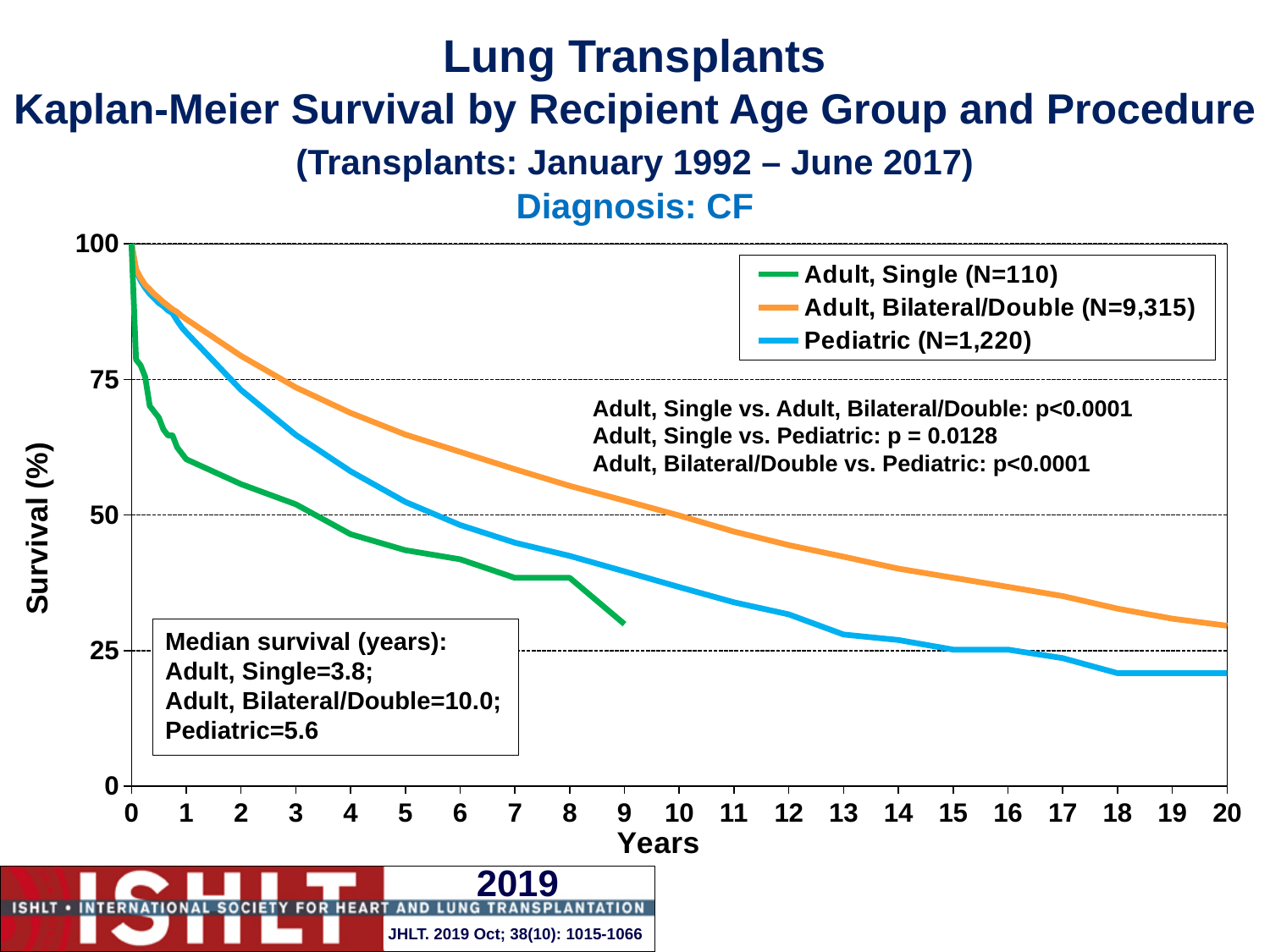
Which group has the lowest median survival? Adult, Single What is the median survival in years for the Pediatric group? 5.6 What is the median survival in years for the Adult, Single group? 3.8 Which group has the highest median survival? Adult, Bilateral/Double Is the survival value for the Adult, Bilateral/Double group at 20 years greater or less than 25? greater What kind of chart is shown on the slide? line chart How many series does the legend list? 3 What is the difference in median survival (years) between the Adult, Bilateral/Double group and the Pediatric group? 4.4 Do the survival curves rise or fall as years increase along the x axis? fall Is the survival value for the Pediatric group at 18 years greater or less than 25? less At 5 years, which curve shows higher survival: Adult, Bilateral/Double or Pediatric? Adult, Bilateral/Double What is the median survival in years for the Adult, Bilateral/Double group? 10.0